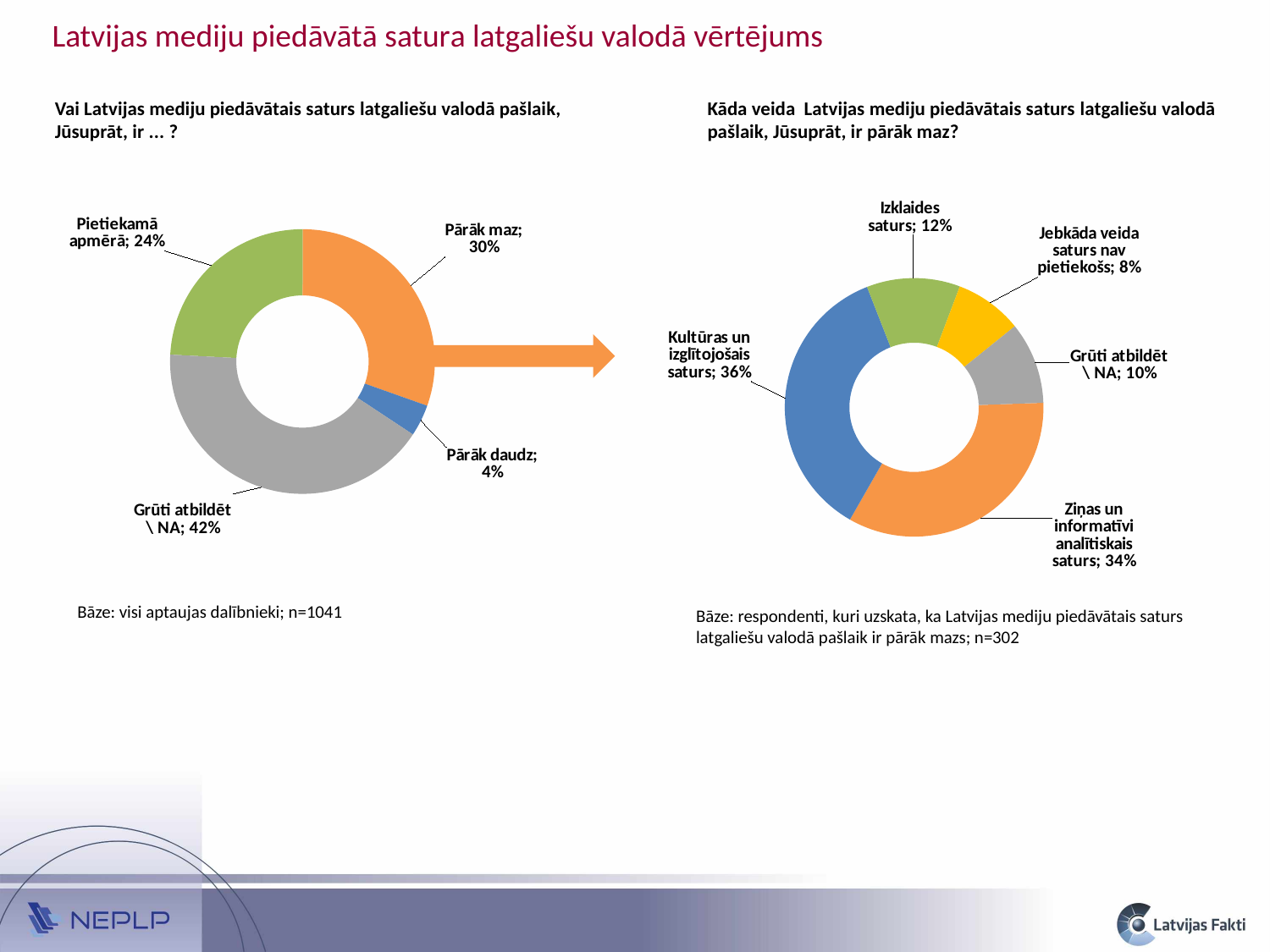
In the right chart, what share is given for "Jebkāda veida saturs nav pietiekošs"? 8% In the left chart, what share of respondents answered "Grūti atbildēt \ NA"? 42% What type of chart is used on the left side of the slide? Doughnut (pie) chart In the left chart, which category has the largest share? Grūti atbildēt \ NA In the right chart, what share is given for "Kultūras un izglītojošais saturs"? 36% How many categories does the right chart show? 5 In the right chart, which is larger: "Izklaides saturs" or "Grūti atbildēt \ NA"? Izklaides saturs How many categories does the left chart show? 4 In the left chart, what share of respondents answered "Pārāk maz"? 30% In the left chart, which category has the smallest share? Pārāk daudz In the right chart, which category has the largest share? Kultūras un izglītojošais saturs In the left chart, what is the difference in percentage points between "Pārāk maz" and "Pietiekamā apmērā"? 6